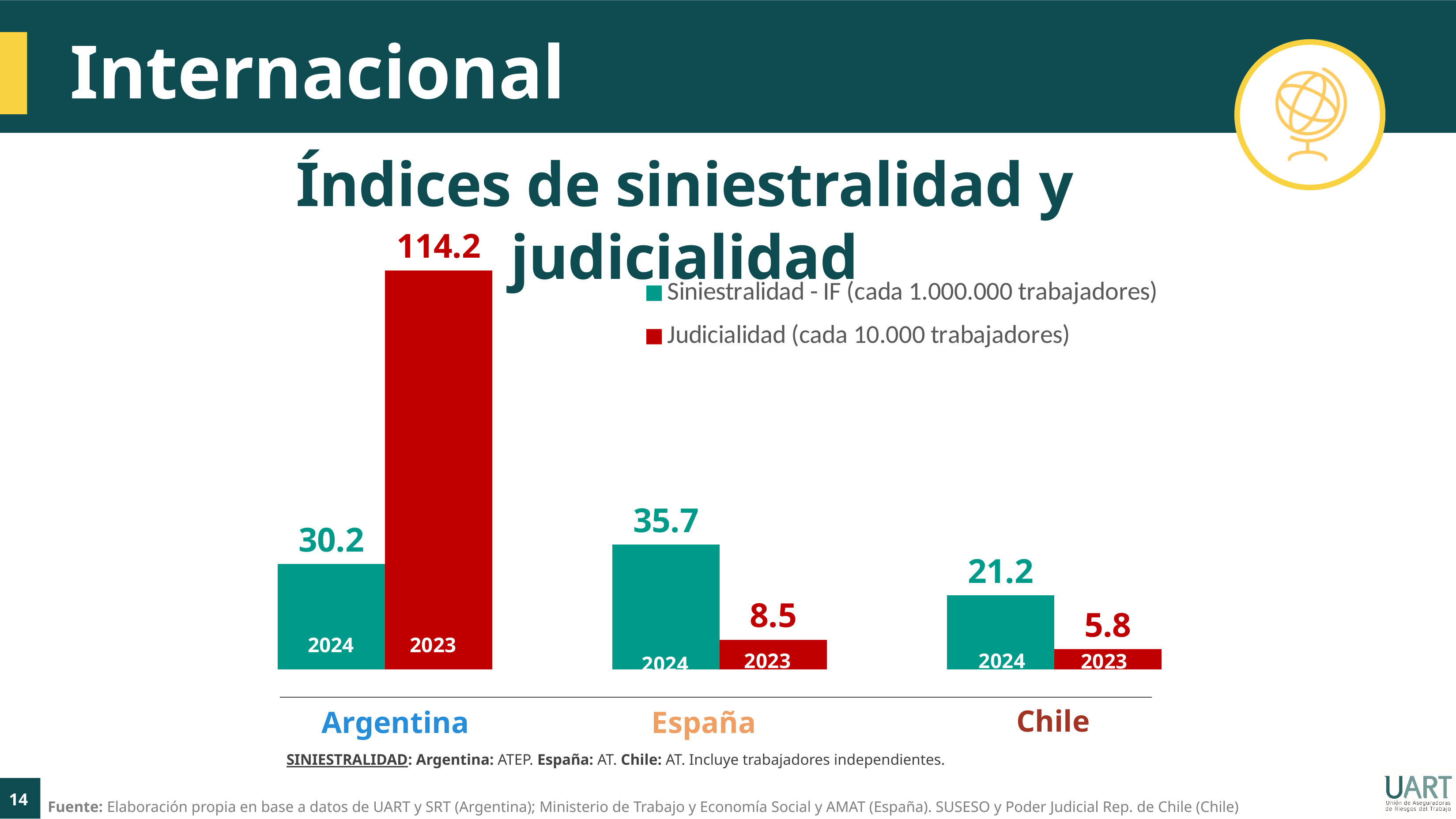
How many series does the legend list? 2 Which country has the highest Siniestralidad - IF value? España What kind of chart is shown on the slide? Bar chart Which country has the lowest Judicialidad value? Chile Which colour represents the Judicialidad series in the chart? Red What is the Siniestralidad - IF value for España? 35.7 What is the difference between the Judicialidad values for Argentina and España? 105.7 What is the Judicialidad value for Argentina? 114.2 How many countries are shown on the x axis of the chart? 3 What is the Judicialidad value for Chile? 5.8 What is the Siniestralidad - IF value for Argentina? 30.2 Which is larger, the Siniestralidad - IF value for Chile or the Judicialidad value for Chile? Siniestralidad - IF value for Chile